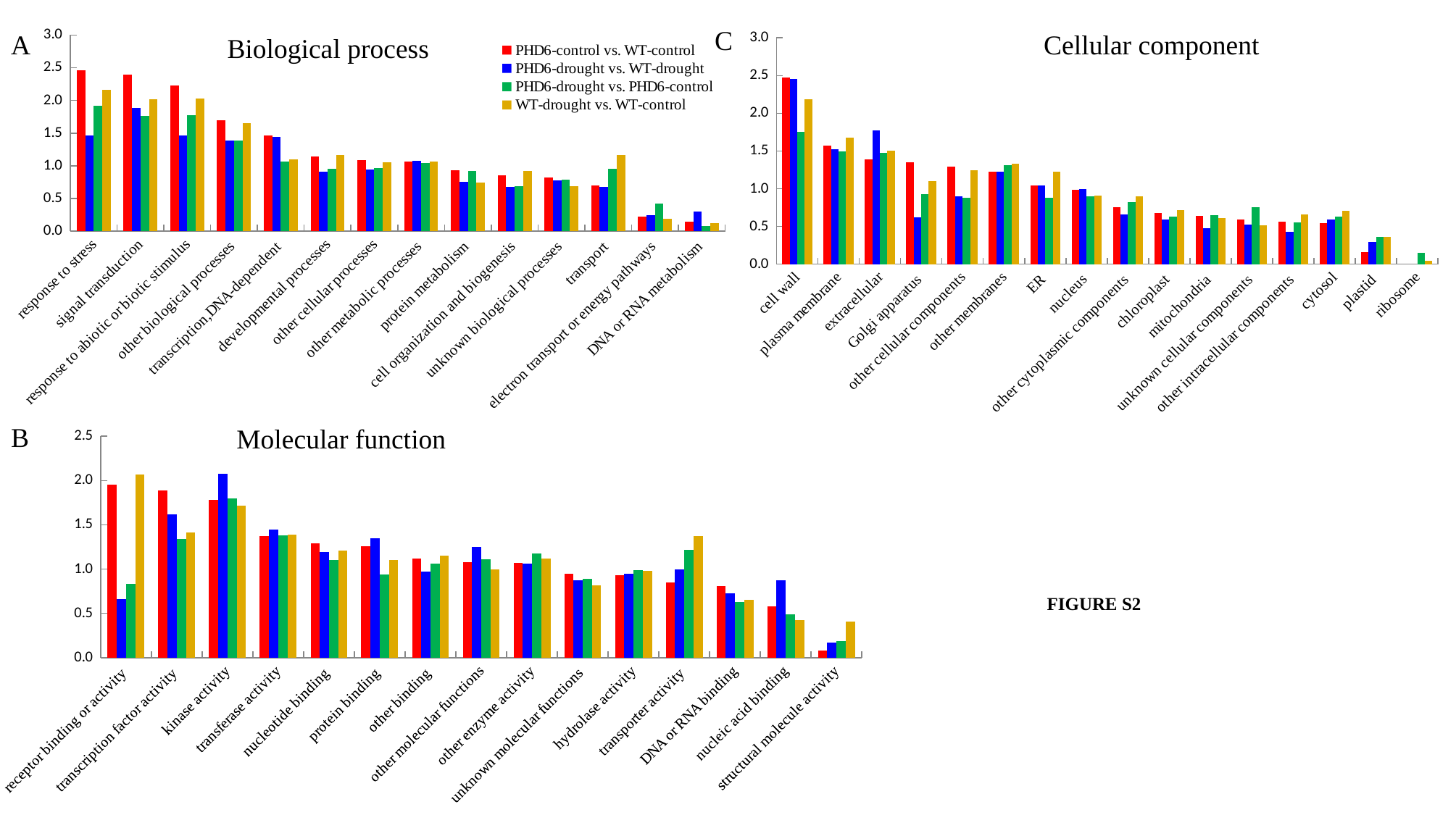
How many categories are shown on the x axis of the Biological process chart? 14 How many categories are shown on the x axis of the Cellular component chart? 16 In the Cellular component chart, which category has the highest PHD6-control vs. WT-control value? cell wall How many categories are shown on the x axis of the Molecular function chart? 15 What kind of chart is the Biological process chart? bar chart In the Cellular component chart, is the PHD6-control vs. WT-control value for cell wall greater or less than 2.0? greater In the Molecular function chart, for receptor binding or activity, which is larger: the WT-drought vs. WT-control value or the PHD6-drought vs. WT-drought value? WT-drought vs. WT-control In the Molecular function chart, is the PHD6-drought vs. WT-drought value for receptor binding or activity greater or less than 1.0? less In the Biological process chart, is the PHD6-control vs. WT-control value for response to stress greater or less than 2.0? greater What is the title of the chart labelled C? Cellular component In the Cellular component chart, for Golgi apparatus, which is larger: the PHD6-control vs. WT-control value or the PHD6-drought vs. WT-drought value? PHD6-control vs. WT-control How many series does the legend list for the charts? 4